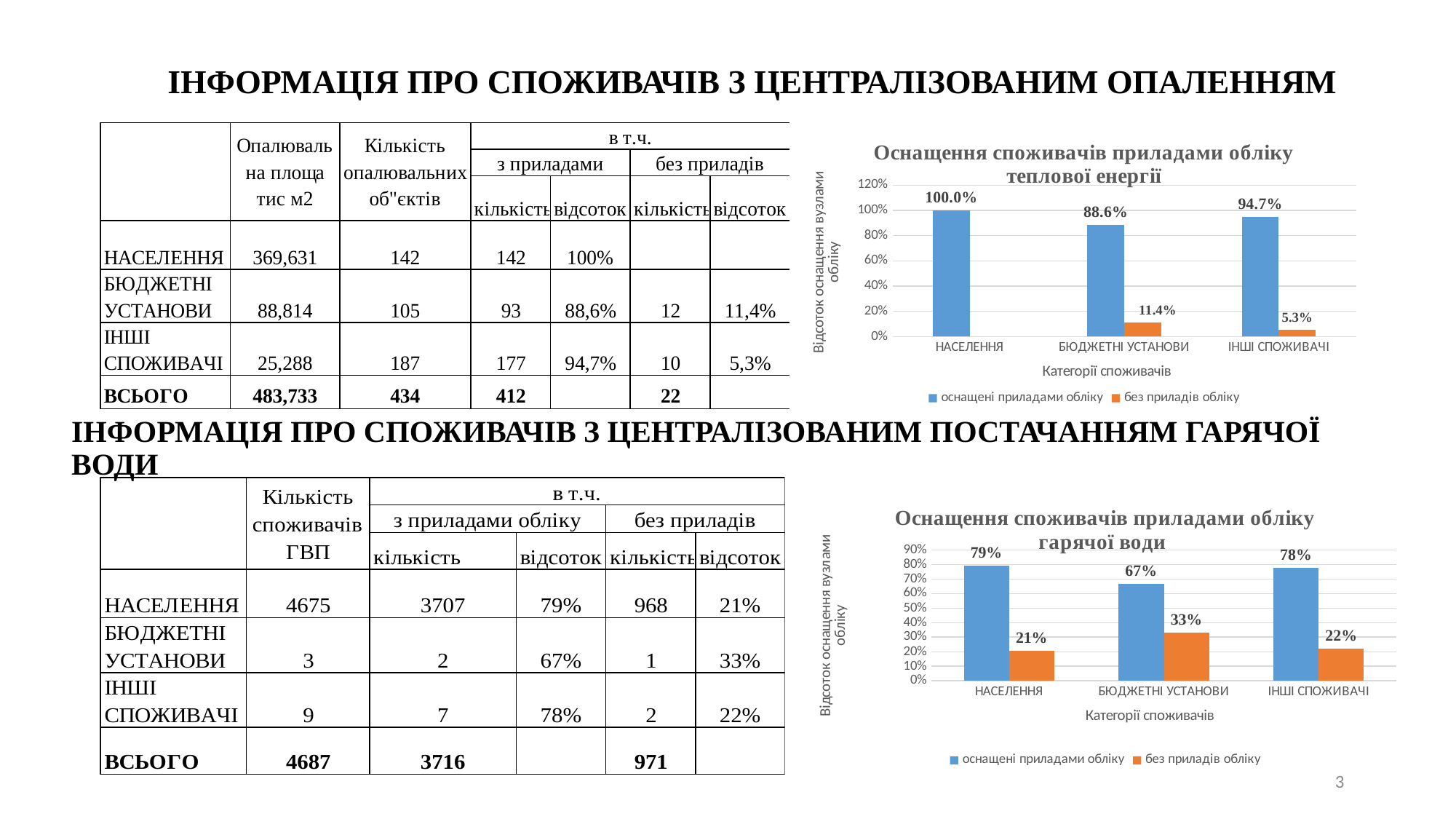
In the bottom chart (Оснащення споживачів приладами обліку гарячої води), what is the difference between the оснащені приладами обліку and без приладів обліку values for НАСЕЛЕННЯ? 58% In the top chart (Оснащення споживачів приладами обліку теплової енергії), what is the label on the x axis? Категорії споживачів In the top chart (Оснащення споживачів приладами обліку теплової енергії), how many series does the legend list? 2 In the bottom chart (Оснащення споживачів приладами обліку гарячої води), what is the value for ІНШІ СПОЖИВАЧІ in the series без приладів обліку? 22% In the top chart (Оснащення споживачів приладами обліку теплової енергії), what is the value for НАСЕЛЕННЯ in the series оснащені приладами обліку? 100.0% In the top chart (Оснащення споживачів приладами обліку теплової енергії), which category has the lowest value in the series оснащені приладами обліку? БЮДЖЕТНІ УСТАНОВИ In the top chart (Оснащення споживачів приладами обліку теплової енергії), what is the value for БЮДЖЕТНІ УСТАНОВИ in the series без приладів обліку? 11.4% In the bottom chart (Оснащення споживачів приладами обліку гарячої води), what is the value for БЮДЖЕТНІ УСТАНОВИ in the series оснащені приладами обліку? 67% In the top chart (Оснащення споживачів приладами обліку теплової енергії), what is the difference between the оснащені приладами обліку values for ІНШІ СПОЖИВАЧІ and БЮДЖЕТНІ УСТАНОВИ? 6.1% In the bottom chart (Оснащення споживачів приладами обліку гарячої води), how many categories are shown on the x axis? 3 What kind of chart is the bottom chart (Оснащення споживачів приладами обліку гарячої води)? bar chart In the bottom chart (Оснащення споживачів приладами обліку гарячої води), which category has the highest value in the series без приладів обліку? БЮДЖЕТНІ УСТАНОВИ